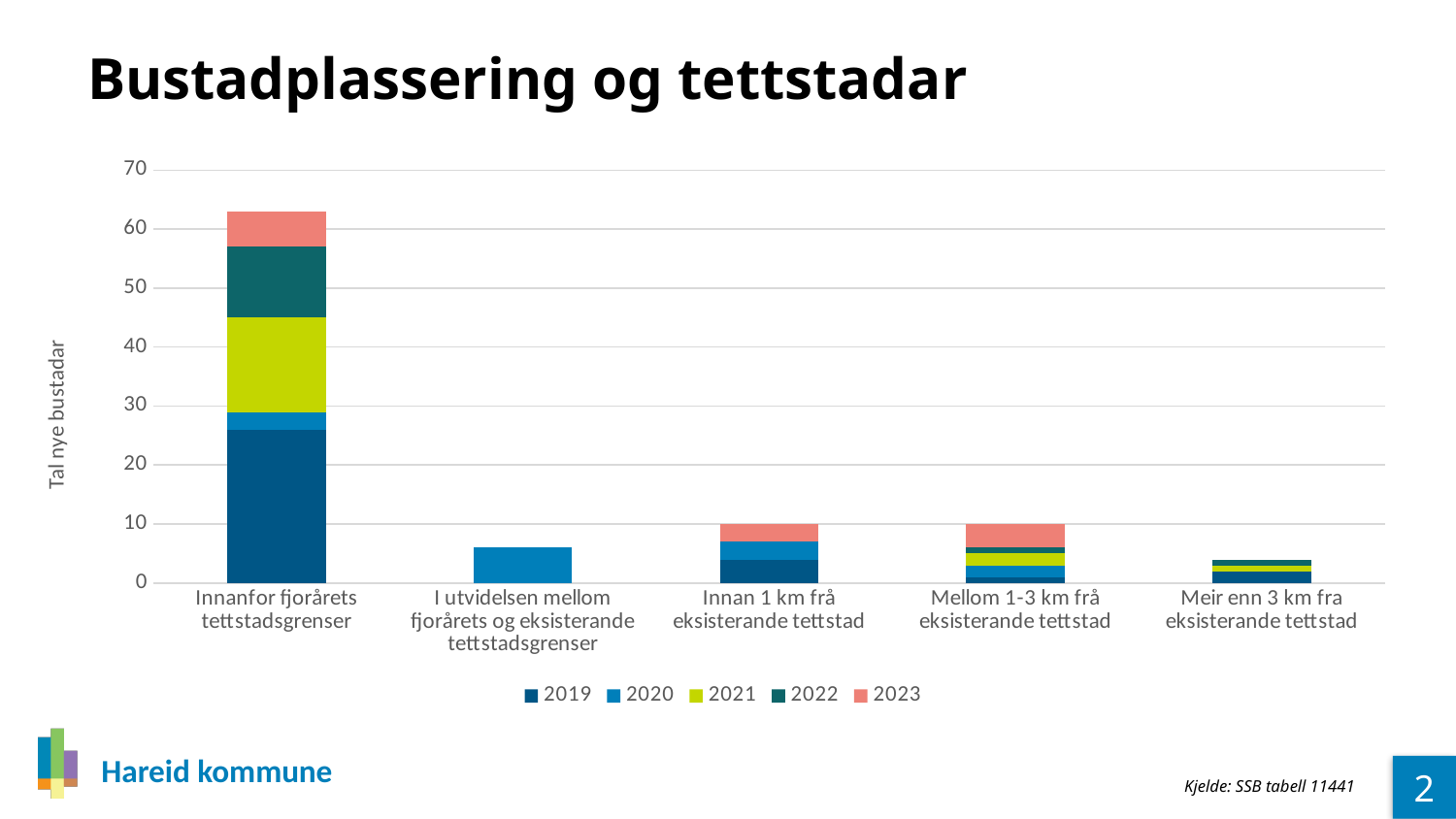
What is the title of the chart on the slide? Bustadplassering og tettstadar How many series does the legend list? 5 How many categories are shown on the x axis of the chart? 5 Which single year series makes up the entire bar for 'I utvidelsen mellom fjorårets og eksisterande tettstadsgrenser'? 2020 Which category has the highest total number of new dwellings? Innanfor fjorårets tettstadsgrenser Is the total for 'Innanfor fjorårets tettstadsgrenser' greater or less than 60? greater Which category has the lowest total number of new dwellings? Meir enn 3 km fra eksisterande tettstad Is the total for 'I utvidelsen mellom fjorårets og eksisterande tettstadsgrenser' greater or less than 10? less Is the 2019 value for 'Innanfor fjorårets tettstadsgrenser' greater or less than 20? greater Which has a larger total: 'Innanfor fjorårets tettstadsgrenser' or 'Innan 1 km frå eksisterande tettstad'? Innanfor fjorårets tettstadsgrenser What kind of chart is shown on the slide? Stacked bar chart